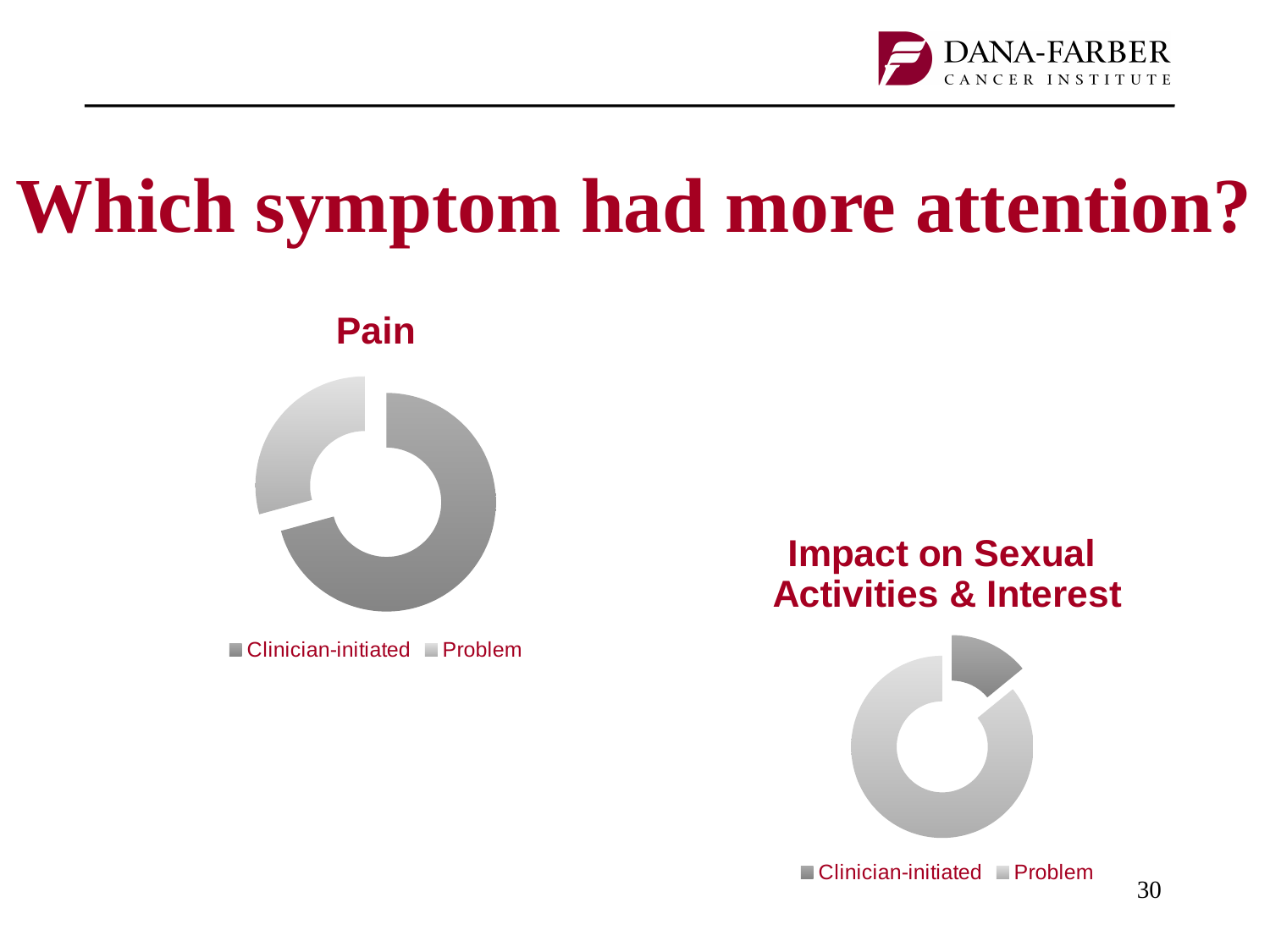
In the "Impact on Sexual Activities & Interest" chart, how many entries does the legend list? 2 What is the title of the chart on the right of the slide? Impact on Sexual Activities & Interest In the "Impact on Sexual Activities & Interest" chart, which slice is larger, Clinician-initiated or Problem? Problem In the "Impact on Sexual Activities & Interest" chart, which category has the largest slice? Problem In the "Impact on Sexual Activities & Interest" chart, which category has the smallest slice? Clinician-initiated What kind of chart is the "Impact on Sexual Activities & Interest" chart? Doughnut chart What kind of chart is the "Pain" chart? Doughnut chart In the "Pain" chart, which category has the smallest slice? Problem In the "Pain" chart, how many entries does the legend list? 2 In the "Pain" chart, which slice is larger, Clinician-initiated or Problem? Clinician-initiated What is the title of the chart on the left of the slide? Pain In the "Pain" chart, how many slices does the doughnut have? 2